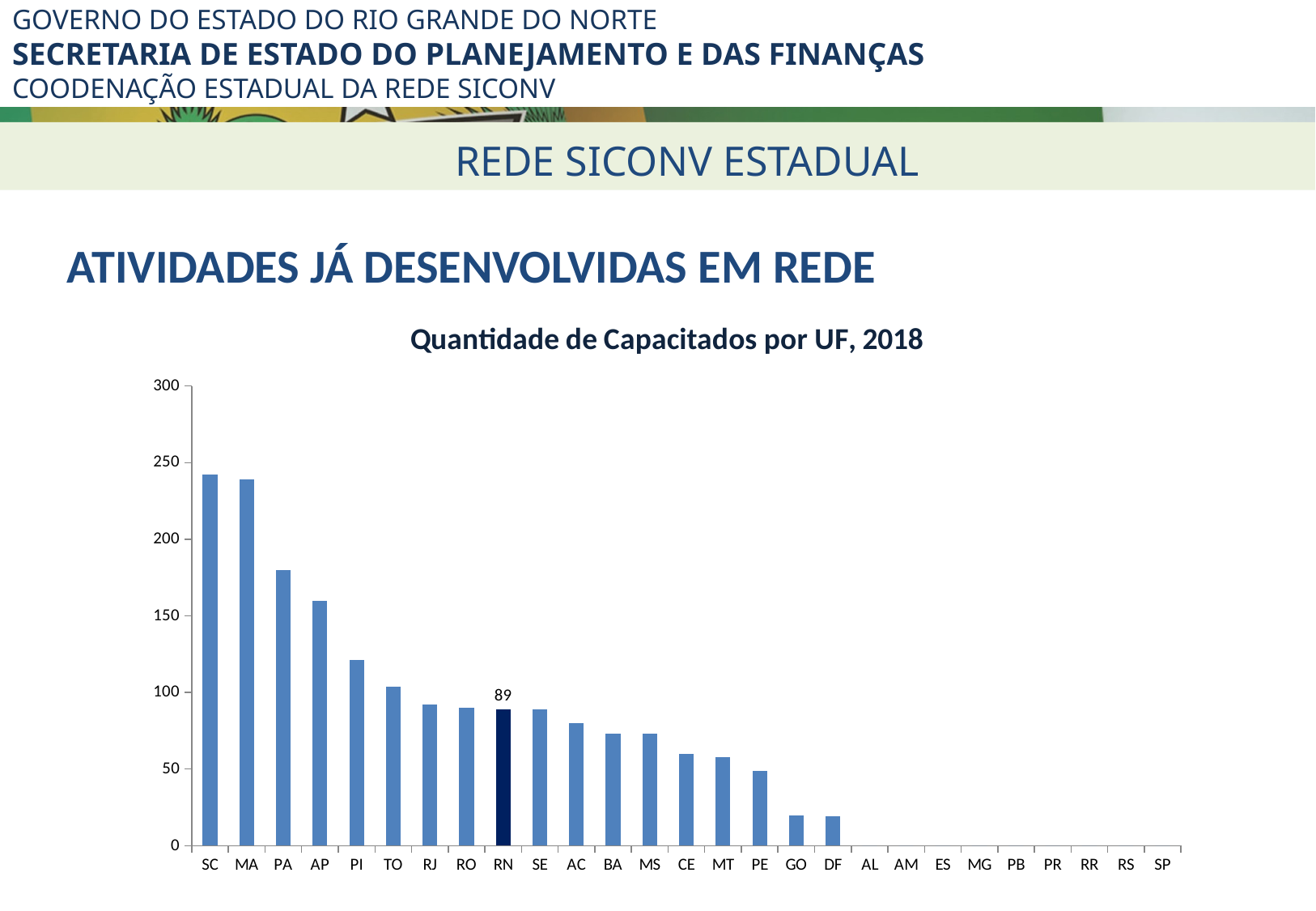
Is the value for PA greater or less than 150? greater What is the title of the chart? Quantidade de Capacitados por UF, 2018 What is the value for RN in the chart 'Quantidade de Capacitados por UF, 2018'? 89 What kind of chart is shown on the slide? bar chart How many UF categories are listed along the x axis of the chart? 27 Which has a larger value, PA or AP? PA Is the value for GO greater or less than 50? less Which UF's bar is highlighted in a dark navy colour, different from the other bars? RN Is the value for SC greater or less than 200? greater Do the values rise or fall moving from left to right along the x axis? fall Which has a larger value, PI or TO? PI